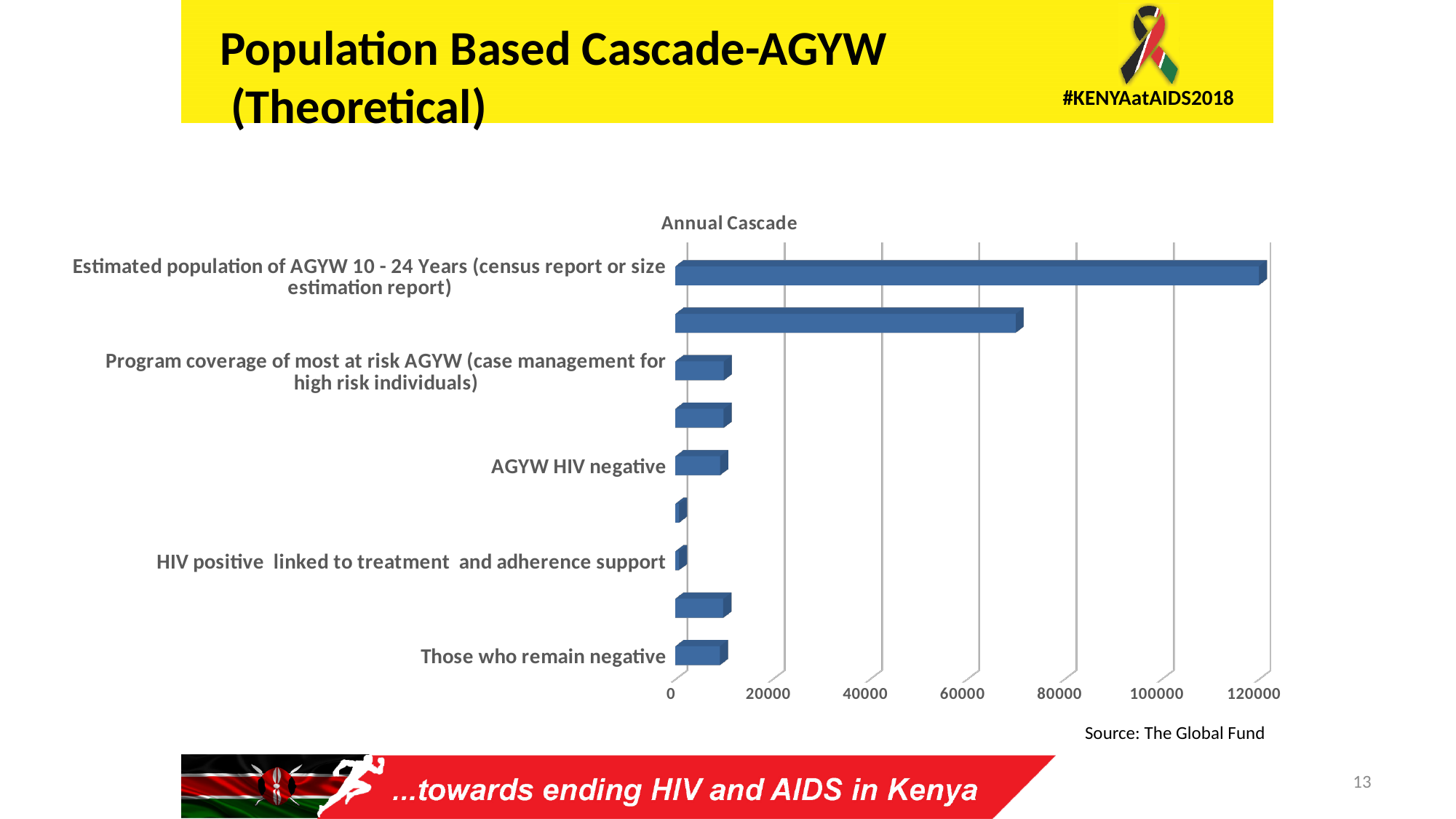
What source is cited for the chart data? The Global Fund Is the value for Those who remain negative greater or less than 20000? less How many bars are plotted in the chart? 9 Which is larger: the value for Estimated population of AGYW 10 - 24 Years or the value for Program coverage of most at risk AGYW? Estimated population of AGYW 10 - 24 Years Is the value for Program coverage of most at risk AGYW greater or less than 20000? less What type of chart is shown on the slide? bar chart Which is larger: the value for AGYW HIV negative or the value for HIV positive linked to treatment and adherence support? AGYW HIV negative Is the value for Estimated population of AGYW 10 - 24 Years greater or less than 100000? greater Which category has the highest value in the chart? Estimated population of AGYW 10 - 24 Years (census report or size estimation report) What is the title of the chart? Annual Cascade